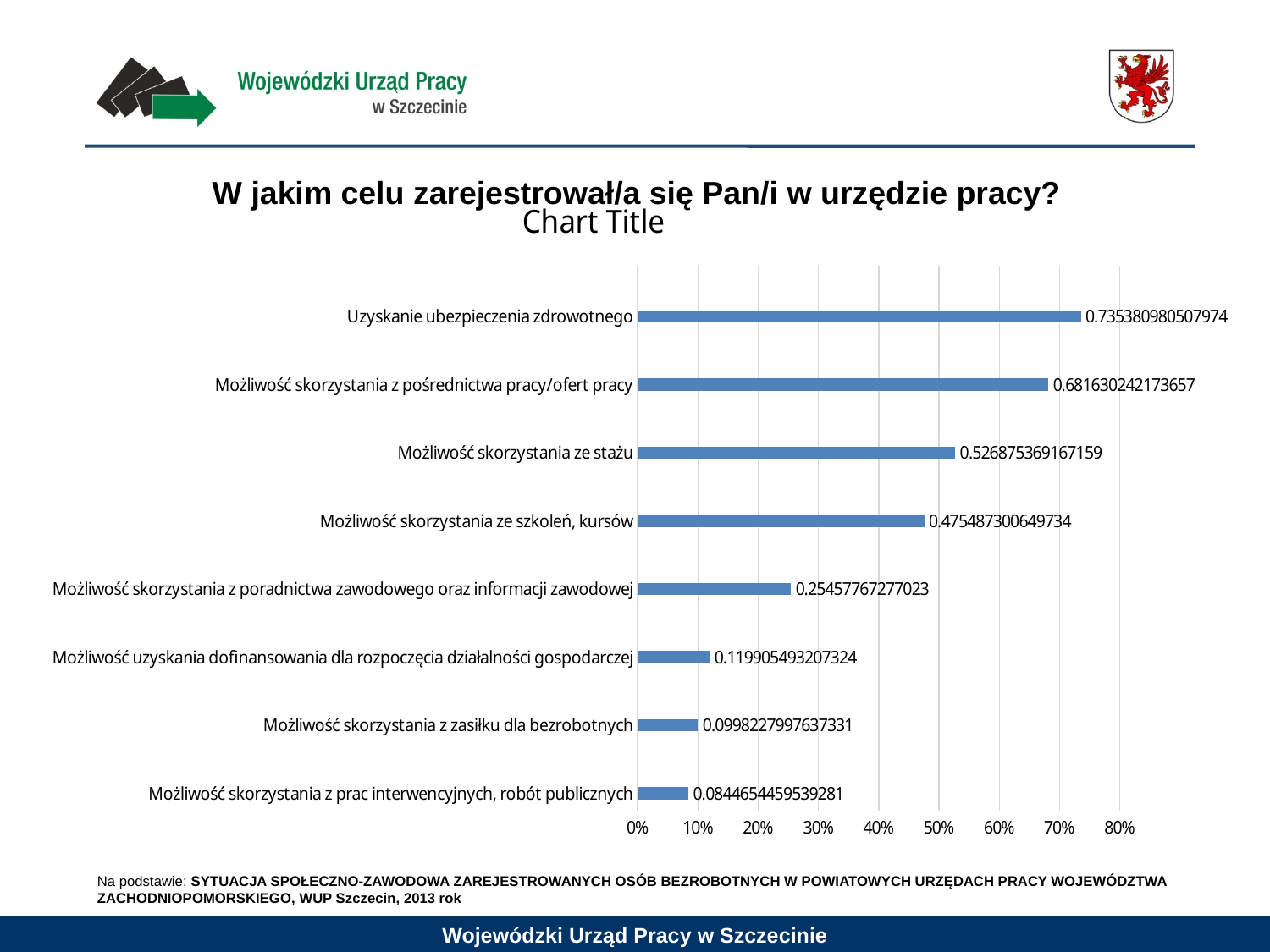
What is the value for "Uzyskanie ubezpieczenia zdrowotnego"? 0.735380980507974 What is the question shown as the heading above the chart? W jakim celu zarejestrował/a się Pan/i w urzędzie pracy? What is the value for "Możliwość skorzystania z poradnictwa zawodowego oraz informacji zawodowej"? 0.25457767277023 What is the value for "Możliwość skorzystania ze stażu"? 0.526875369167159 Which category has the highest value? Uzyskanie ubezpieczenia zdrowotnego What is the difference between the values for "Uzyskanie ubezpieczenia zdrowotnego" and "Możliwość skorzystania z pośrednictwa pracy/ofert pracy"? 0.053750738334317 What is the value for "Możliwość skorzystania z zasiłku dla bezrobotnych"? 0.0998227997637331 How many categories are shown in the chart? 8 What kind of chart is shown on the slide? bar chart Is the value for "Możliwość skorzystania ze szkoleń, kursów" greater or less than 50%? less Which category has the lowest value? Możliwość skorzystania z prac interwencyjnych, robót publicznych Which is larger: the value for "Możliwość skorzystania ze szkoleń, kursów" or for "Możliwość skorzystania ze stażu"? Możliwość skorzystania ze stażu